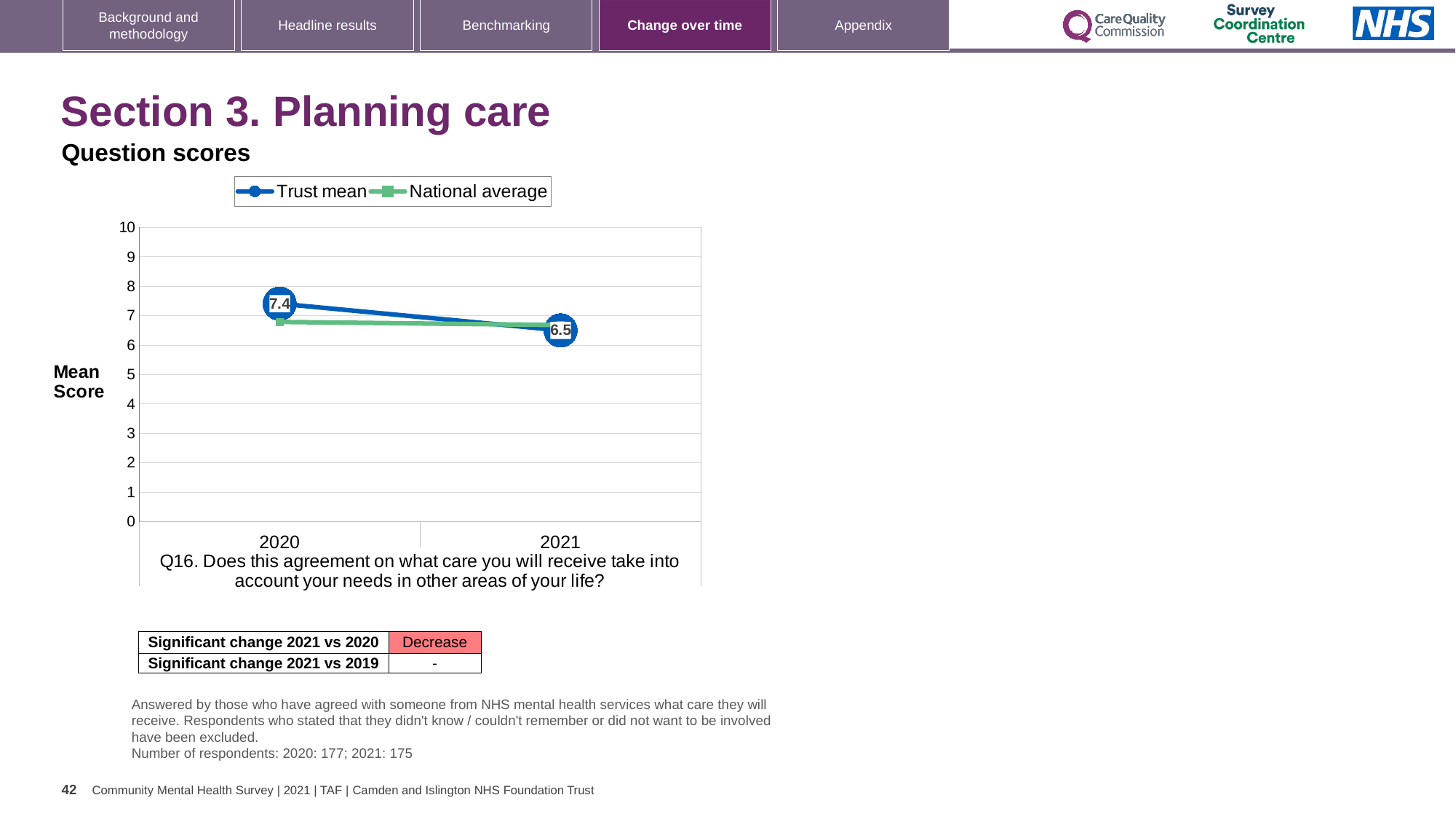
In 2020, which is larger: the Trust mean or the National average? Trust mean Is the National average for 2021 greater or less than 6? greater Is the National average for 2020 greater or less than 7? less Does the Trust mean score rise or fall from 2020 to 2021? fall By how much did the Trust mean score change from 2020 to 2021? 0.9 What is the label on the y axis of the chart? Mean Score What kind of chart is shown on the slide? line chart What is the Trust mean score for 2020? 7.4 How many series does the legend list? 2 How many years are plotted on the x axis? 2 In which year is the Trust mean score highest? 2020 What is the Trust mean score for 2021? 6.5